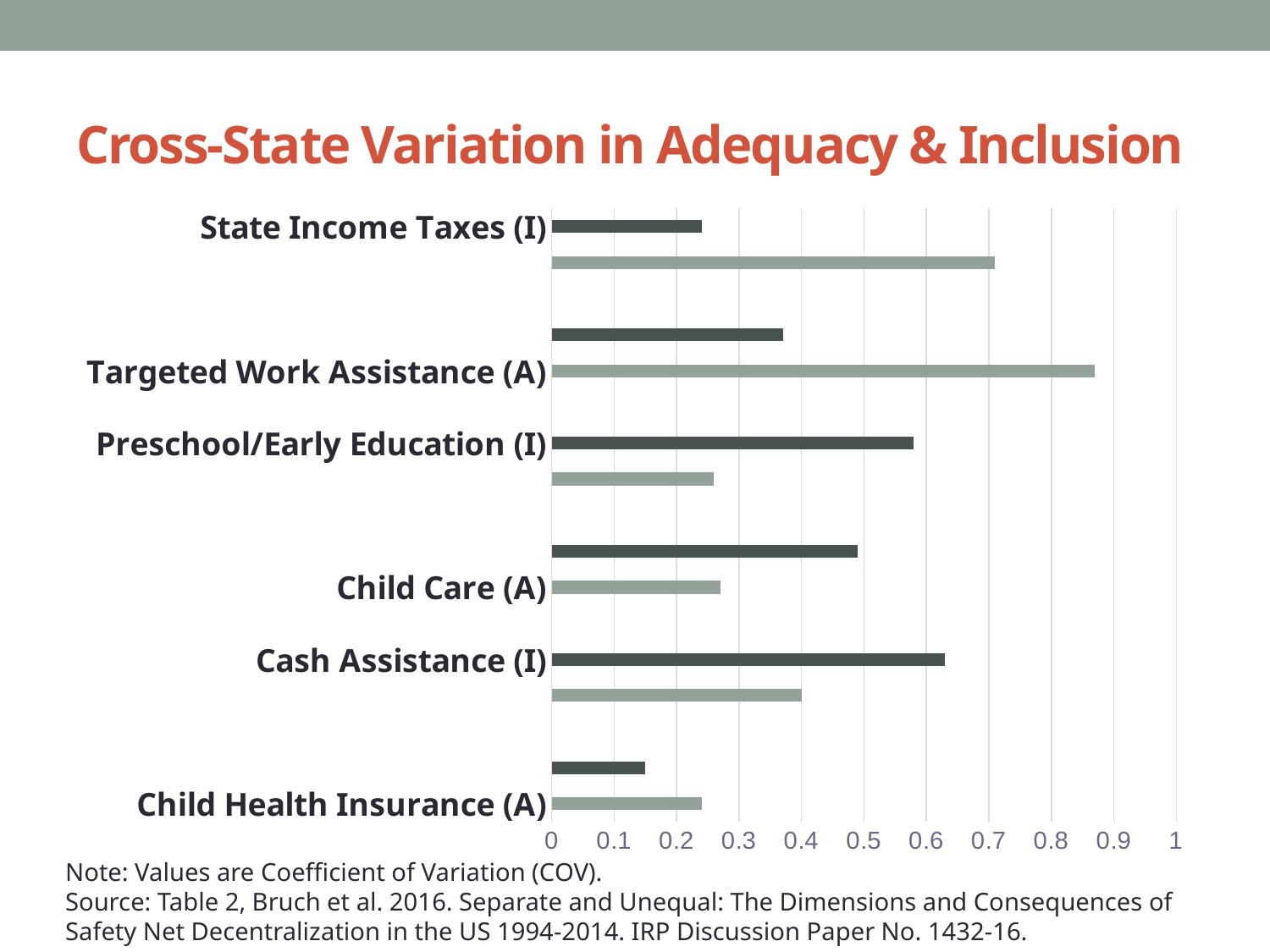
Which category has the shortest dark green bar? Child Health Insurance (A) For Preschool/Early Education (I), which bar is longer, the dark green or the light green? dark green What is the title of the chart on the slide? Cross-State Variation in Adequacy & Inclusion Is the dark green bar for Child Health Insurance (A) greater or less than 0.2? less Which category has the longest light green bar? Targeted Work Assistance (A) How many categories are shown on the chart? 6 Is the light green bar for State Income Taxes (I) greater or less than 0.6? greater Is the light green bar for Targeted Work Assistance (A) greater or less than 0.8? greater Which category has the longest dark green bar? Cash Assistance (I) How many bars are plotted for each category on the chart? 2 What kind of chart is shown on the slide? bar chart For State Income Taxes (I), which bar is longer, the dark green or the light green? light green